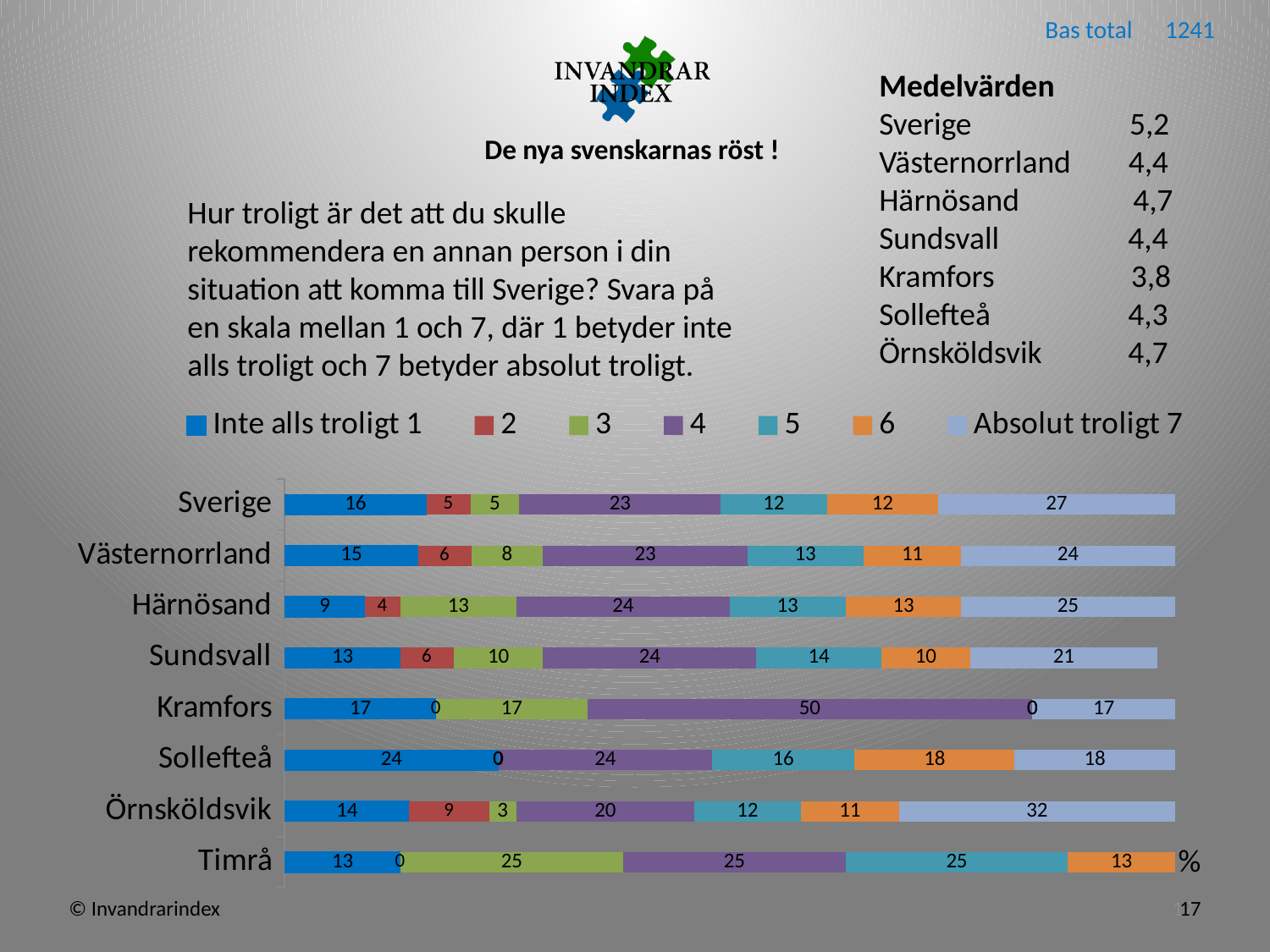
What is the value for 'Absolut troligt 7' for Sverige? 27 Which is larger: the '3' value for Härnösand or the '3' value for Västernorrland? Härnösand Which region has the highest value for 'Absolut troligt 7'? Örnsköldsvik Which region has the lowest value for 'Inte alls troligt 1'? Härnösand What is the difference between the 'Absolut troligt 7' values for Örnsköldsvik and Sundsvall? 11 What is the value for '4' for Kramfors? 50 What kind of chart is shown on the slide? Stacked bar chart How many series does the chart legend list? 7 What is the label of the first legend entry? Inte alls troligt 1 What is the total of the stacked bar for Sverige? 100 What is the value for 'Inte alls troligt 1' for Sollefteå? 24 How many categories (regions) are plotted on the chart? 8